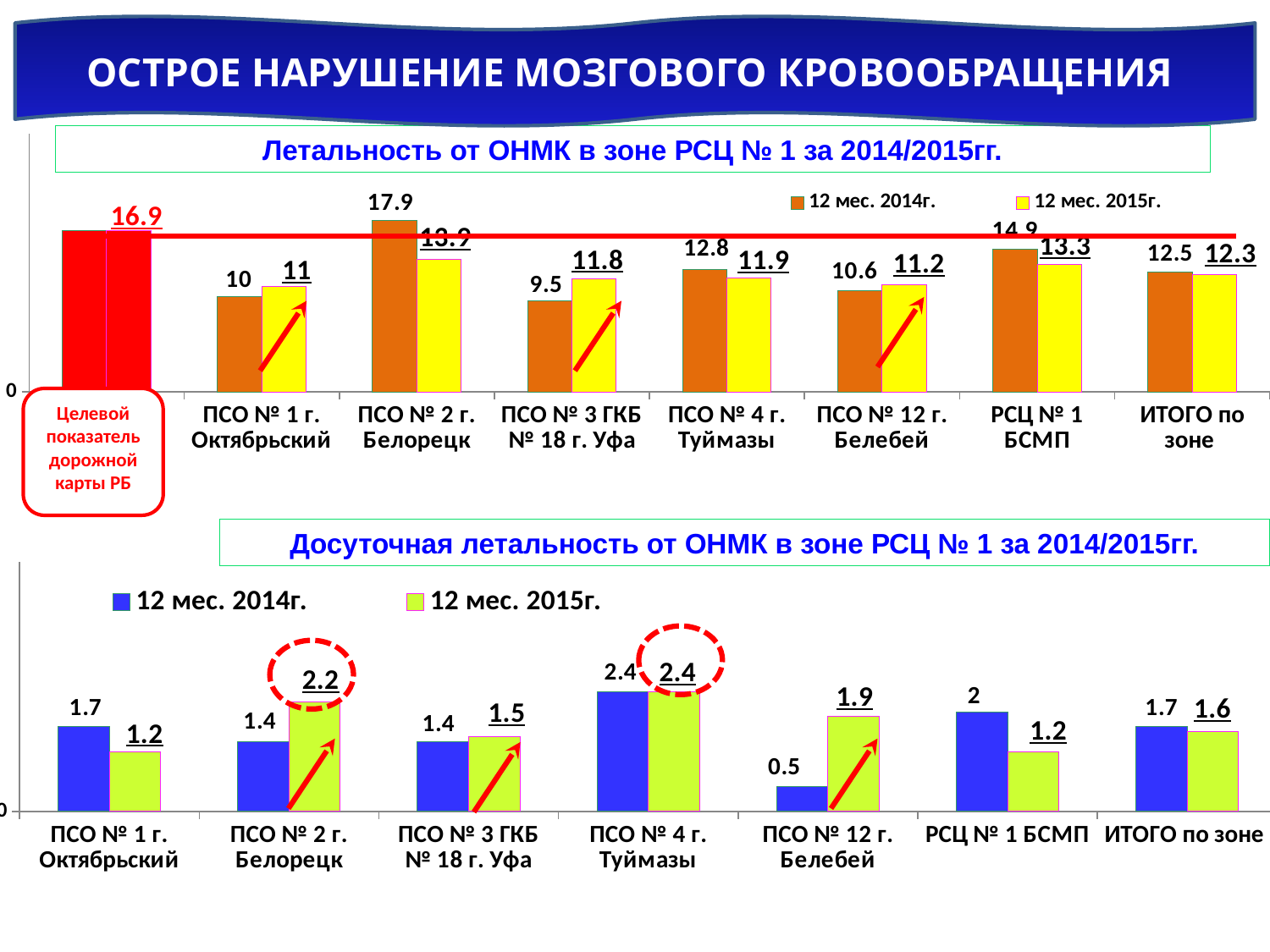
In the top chart 'Летальность от ОНМК в зоне РСЦ № 1 за 2014/2015гг.', what is the value for ИТОГО по зоне for 12 мес. 2014г.? 12.5 In the bottom chart 'Досуточная летальность от ОНМК в зоне РСЦ № 1 за 2014/2015гг.', what is the value for ПСО № 12 г. Белебей for 12 мес. 2014г.? 0.5 In the top chart 'Летальность от ОНМК в зоне РСЦ № 1 за 2014/2015гг.', which category has the highest value for 12 мес. 2014г.? ПСО № 2 г. Белорецк In the bottom chart 'Досуточная летальность от ОНМК в зоне РСЦ № 1 за 2014/2015гг.', which category has the highest value for 12 мес. 2015г.? ПСО № 4 г. Туймазы In the top chart 'Летальность от ОНМК в зоне РСЦ № 1 за 2014/2015гг.', what is the difference between the 12 мес. 2015г. and 12 мес. 2014г. values for ПСО № 3 ГКБ № 18 г. Уфа? 2.3 In the bottom chart 'Досуточная летальность от ОНМК в зоне РСЦ № 1 за 2014/2015гг.', how many categories are shown on the x axis? 7 In the bottom chart 'Досуточная летальность от ОНМК в зоне РСЦ № 1 за 2014/2015гг.', which is larger for РСЦ № 1 БСМП: the 12 мес. 2014г. value or the 12 мес. 2015г. value? 12 мес. 2014г. What type of chart is the bottom chart 'Досуточная летальность от ОНМК в зоне РСЦ № 1 за 2014/2015гг.'? Bar chart In the top chart 'Летальность от ОНМК в зоне РСЦ № 1 за 2014/2015гг.', what is the value for ПСО № 3 ГКБ № 18 г. Уфа for 12 мес. 2015г.? 11.8 In the top chart 'Летальность от ОНМК в зоне РСЦ № 1 за 2014/2015гг.', how many series does the legend list? 2 In the top chart 'Летальность от ОНМК в зоне РСЦ № 1 за 2014/2015гг.', which category has the lowest value for 12 мес. 2014г.? ПСО № 3 ГКБ № 18 г. Уфа In the top chart 'Летальность от ОНМК в зоне РСЦ № 1 за 2014/2015гг.', what is the target value (Целевой показатель дорожной карты РБ) shown by the red bar? 16.9